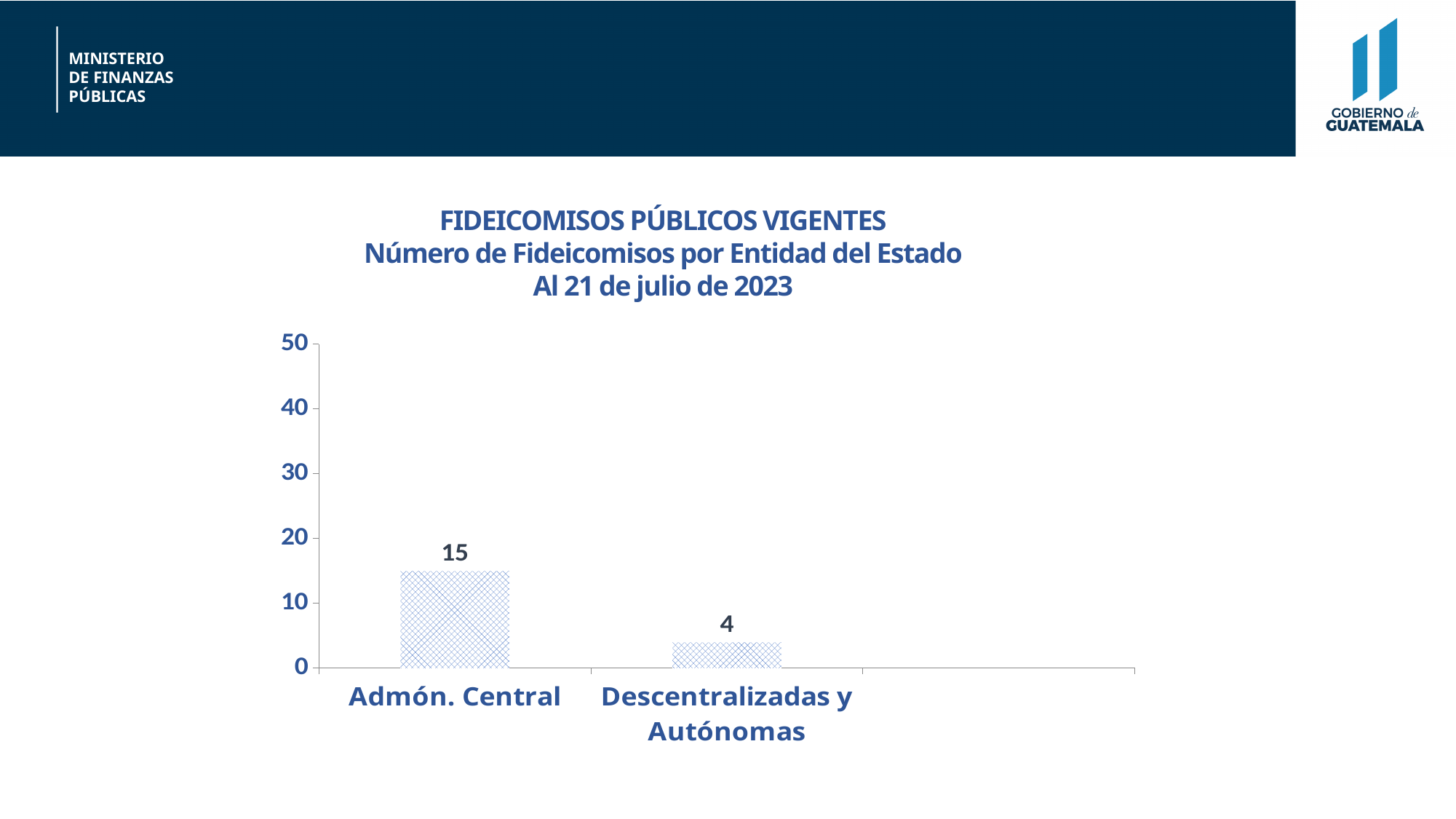
Which category has the lowest value? Descentralizadas y Autónomas What is the value for Descentralizadas y Autónomas? 4 Is the value for Admón. Central greater or less than 20? less What is the value for Admón. Central? 15 What is the difference between the values for Admón. Central and Descentralizadas y Autónomas? 11 What date does the chart title say the data is as of? 21 de julio de 2023 Is the value for Descentralizadas y Autónomas greater or less than 10? less Which is larger, the value for Admón. Central or the value for Descentralizadas y Autónomas? Admón. Central What kind of chart is shown on the slide? bar chart Which category has the highest value? Admón. Central What is the total of the two values plotted in the chart? 19 How many categories are shown on the x axis? 2